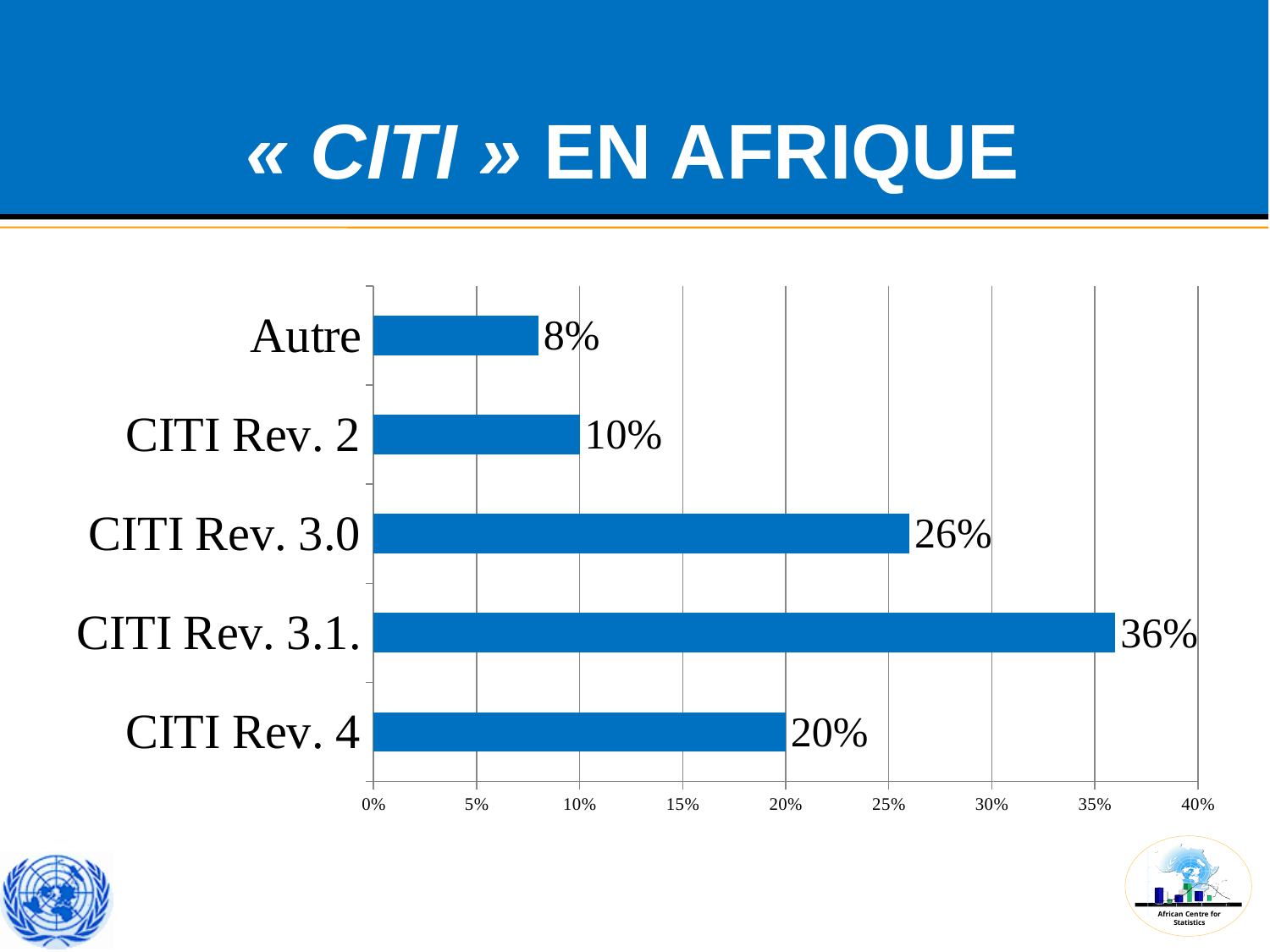
How many categories are shown in the chart? 5 What is the difference between the values for CITI Rev. 3.1. and CITI Rev. 3.0? 10% What is the value for CITI Rev. 2? 10% Which is larger, the value for CITI Rev. 3.0 or the value for CITI Rev. 4? CITI Rev. 3.0 What is the difference between the values for CITI Rev. 4 and CITI Rev. 2? 10% What kind of chart is shown on the slide? Bar chart Which category has the lowest value? Autre Is the value for CITI Rev. 3.0 greater or less than 25%? greater What is the value for CITI Rev. 4? 20% What is the value for Autre? 8% What is the value for CITI Rev. 3.1.? 36% Which category has the highest value? CITI Rev. 3.1.